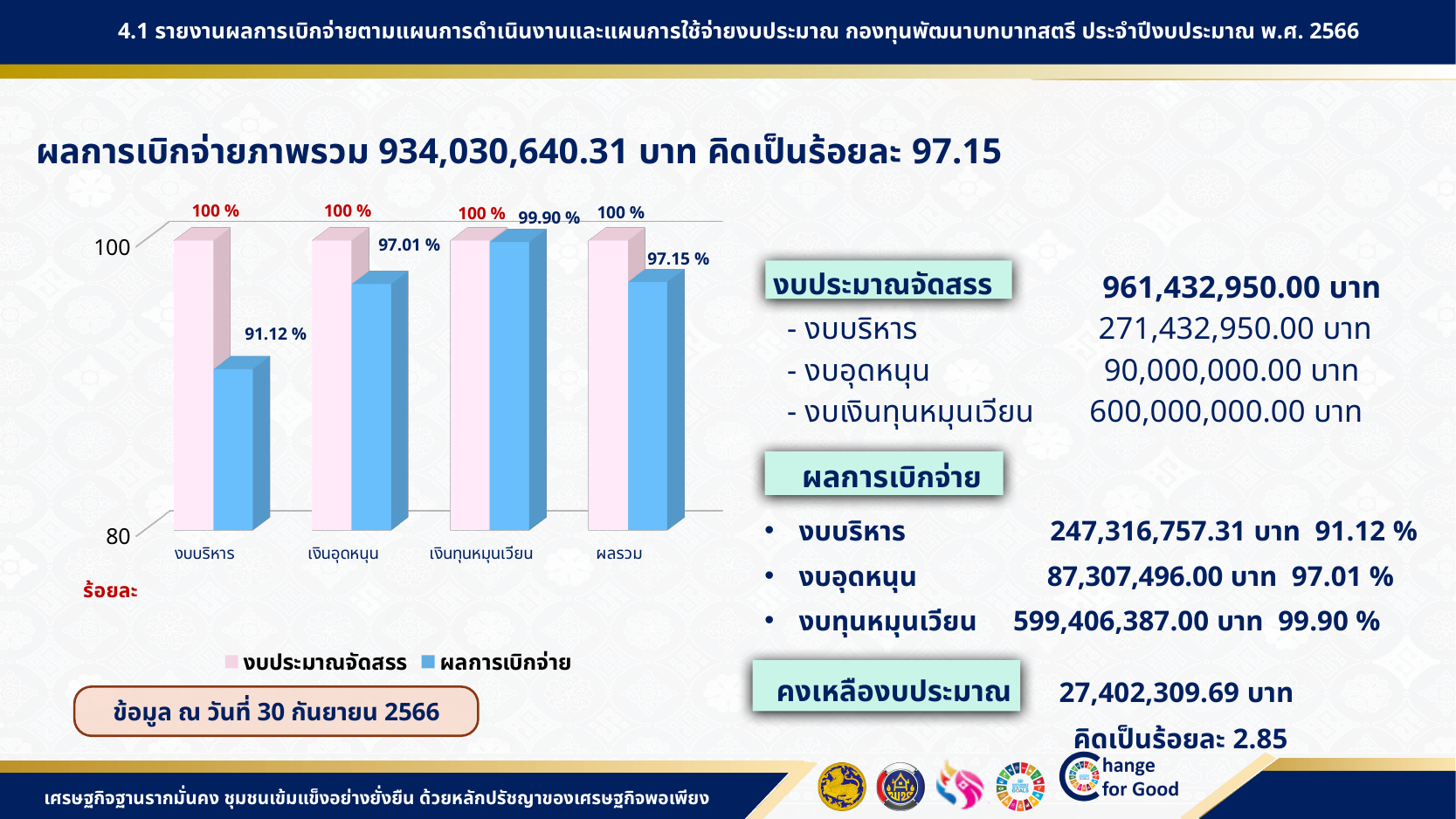
What is the value of ผลการเบิกจ่าย for เงินอุดหนุน in the chart? 97.01 % What is the value of ผลการเบิกจ่าย for ผลรวม in the chart? 97.15 % How many series does the chart legend list? 2 What is the value of ผลการเบิกจ่าย for งบบริหาร in the chart? 91.12 % Which category has the lowest ผลการเบิกจ่าย value in the chart? งบบริหาร What is the difference between the งบประมาณจัดสรร and ผลการเบิกจ่าย values for งบบริหาร in the chart? 8.88 % Which category has the highest ผลการเบิกจ่าย value in the chart? เงินทุนหมุนเวียน What is the value of งบประมาณจัดสรร for เงินอุดหนุน in the chart? 100 % What kind of chart is shown on the slide? bar chart Is the ผลการเบิกจ่าย value for เงินอุดหนุน or for ผลรวม larger in the chart? ผลรวม What is the value of ผลการเบิกจ่าย for เงินทุนหมุนเวียน in the chart? 99.90 % How many categories are shown on the x axis of the chart? 4